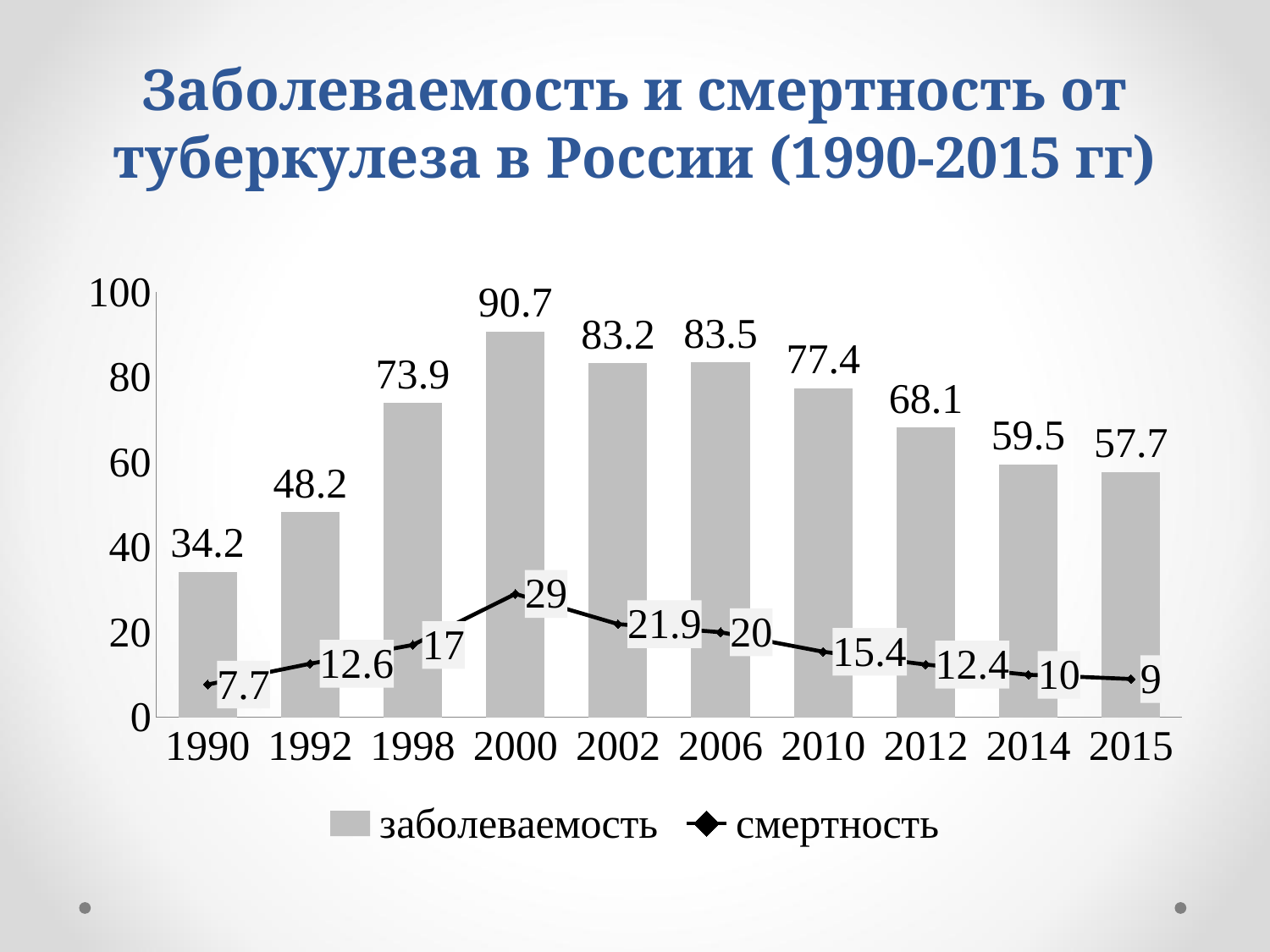
What is the value of смертность in 2010? 15.4 What is the difference between заболеваемость in 2000 and in 2015? 33 Is the value of заболеваемость in 2012 greater or less than 60? greater What is the value of заболеваемость in 2000? 90.7 In which year is смертность lowest? 1990 In which year is заболеваемость highest? 2000 What is the title of the chart on the slide? Заболеваемость и смертность от туберкулеза в России (1990-2015 гг) What kind of chart is used for the заболеваемость series? bar chart Which is larger: смертность in 2002 or in 2006? 2002 Does смертность rise or fall from 2000 to 2015? fall How many years are shown on the x axis? 10 How many series does the legend list? 2